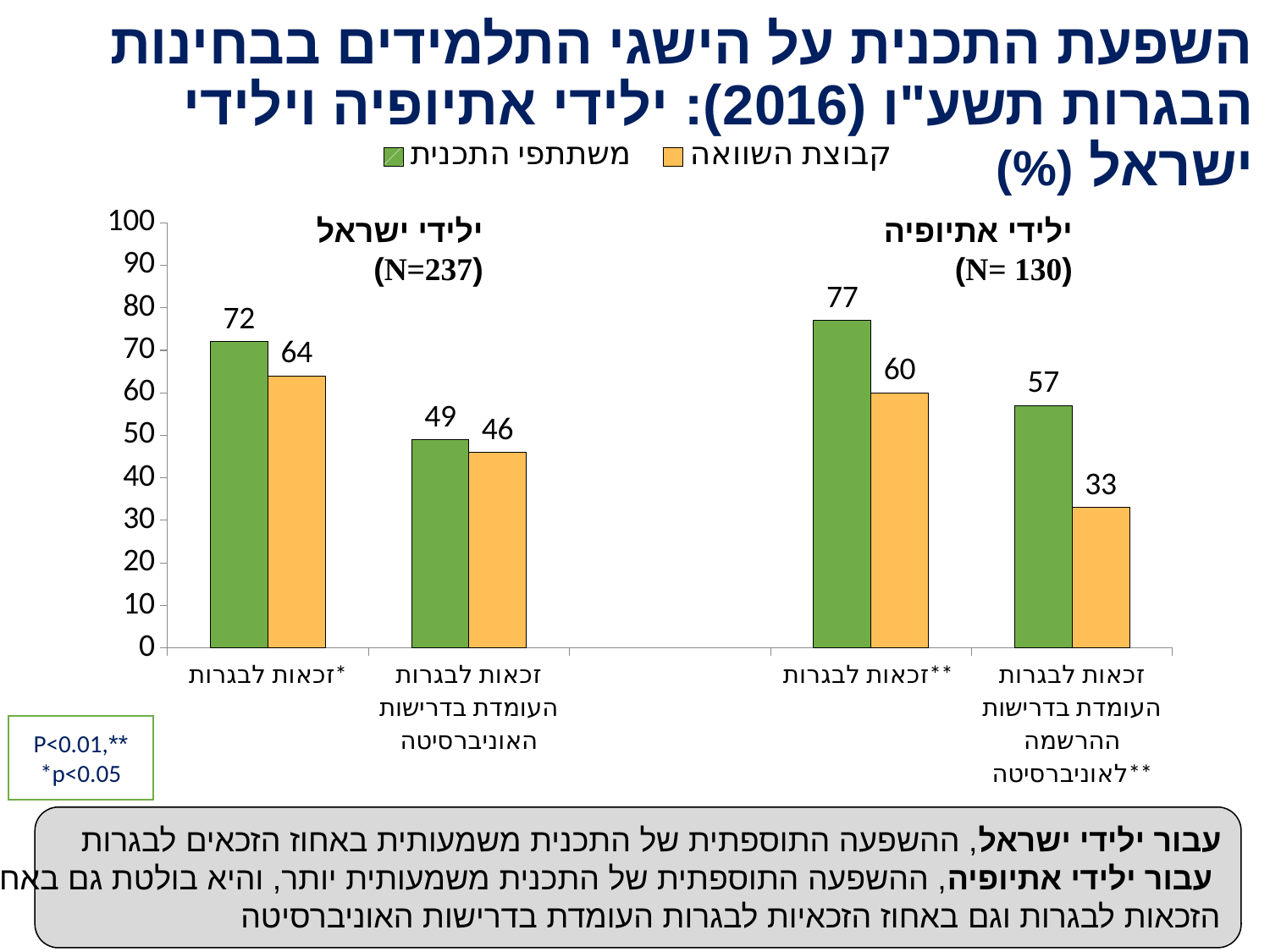
What is the value for program participants (משתתפי התכנית) for זכאות לבגרות העומדת בדרישות האוניברסיטה among ילידי ישראל? 49 What is the value for the comparison group (קבוצת השוואה) for זכאות לבגרות among ילידי אתיופיה? 60 What is the value for the comparison group (קבוצת השוואה) for זכאות לבגרות העומדת בדרישות האוניברסיטה among ילידי אתיופיה? 33 What is the difference between program participants and the comparison group for זכאות לבגרות העומדת בדרישות ההרשמה לאוניברסיטה among ילידי אתיופיה? 24 How many series does the legend list? 2 Which is larger: the program participants' value for זכאות לבגרות among ילידי ישראל or among ילידי אתיופיה? ילידי אתיופיה (77) What is the value for program participants (משתתפי התכנית) for זכאות לבגרות among ילידי ישראל? 72 Which bar has the lowest value on the chart? קבוצת השוואה, זכאות לבגרות העומדת בדרישות ההרשמה לאוניברסיטה, ילידי אתיופיה (33) Which bar has the highest value on the chart? משתתפי התכנית, זכאות לבגרות, ילידי אתיופיה (77) What is the difference between program participants and the comparison group for זכאות לבגרות among ילידי ישראל? 8 What is the sample size (N) shown for ילידי אתיופיה? N= 130 What kind of chart is shown on the slide? Bar chart